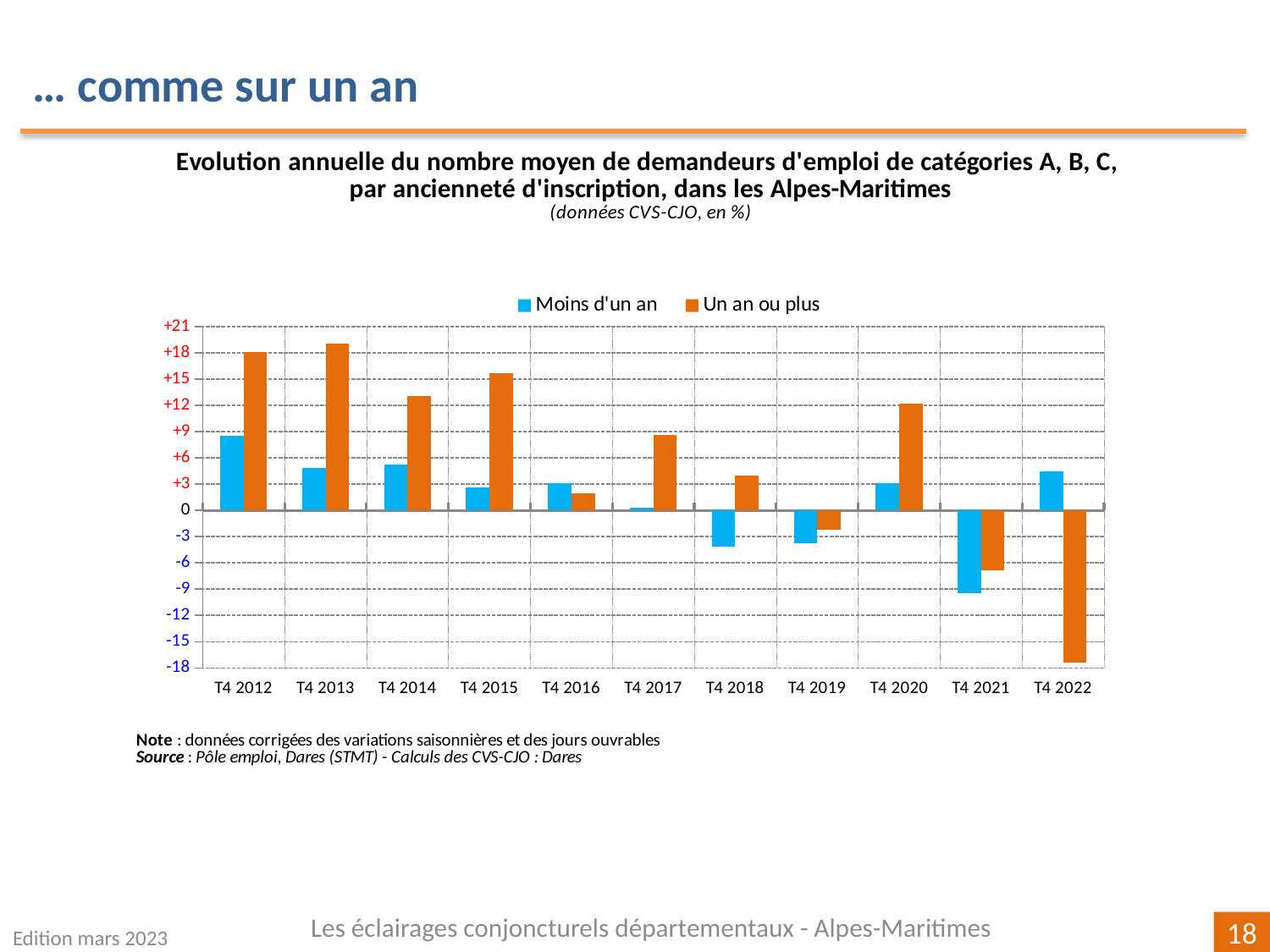
In T4 2018, which series has the larger value, 'Moins d'un an' or 'Un an ou plus'? Un an ou plus How many quarters (categories) are shown on the x axis? 11 Which quarter has the lowest value for the 'Un an ou plus' series? T4 2022 Which quarter has the highest value for the 'Moins d'un an' series? T4 2012 Is the value for 'Un an ou plus' in T4 2020 greater or less than +9? greater How many series does the legend list? 2 Is the value for 'Moins d'un an' in T4 2021 greater or less than -6? less What are the two series named in the legend? Moins d'un an; Un an ou plus Which quarter has the lowest value for the 'Moins d'un an' series? T4 2021 Is the value for 'Un an ou plus' in T4 2022 greater or less than -15? less What kind of chart is shown on the slide? Bar chart